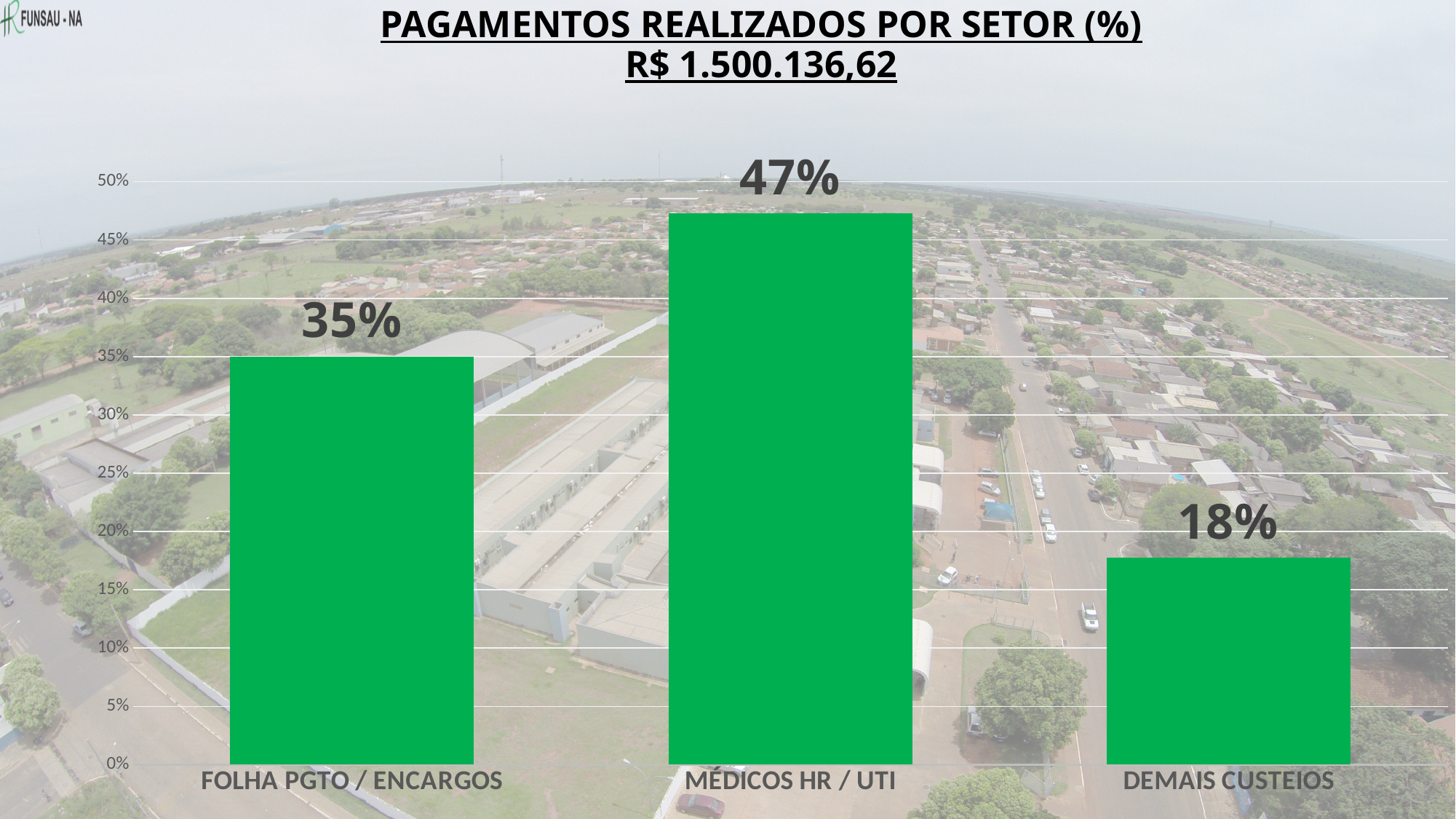
What is the value for FOLHA PGTO / ENCARGOS? 35% Which category has the lowest value? DEMAIS CUSTEIOS How many categories are shown in the chart? 3 What is the value for MÉDICOS HR / UTI? 47% What is the value for DEMAIS CUSTEIOS? 18% Which category has the highest value? MÉDICOS HR / UTI Which is larger, the value for FOLHA PGTO / ENCARGOS or the value for DEMAIS CUSTEIOS? FOLHA PGTO / ENCARGOS What total amount in R$ is shown in the chart title? R$ 1.500.136,62 Is the value for DEMAIS CUSTEIOS greater or less than 20%? less What is the difference between the values for MÉDICOS HR / UTI and FOLHA PGTO / ENCARGOS? 12% What kind of chart is shown on the slide? bar chart What is the difference between the values for FOLHA PGTO / ENCARGOS and DEMAIS CUSTEIOS? 17%